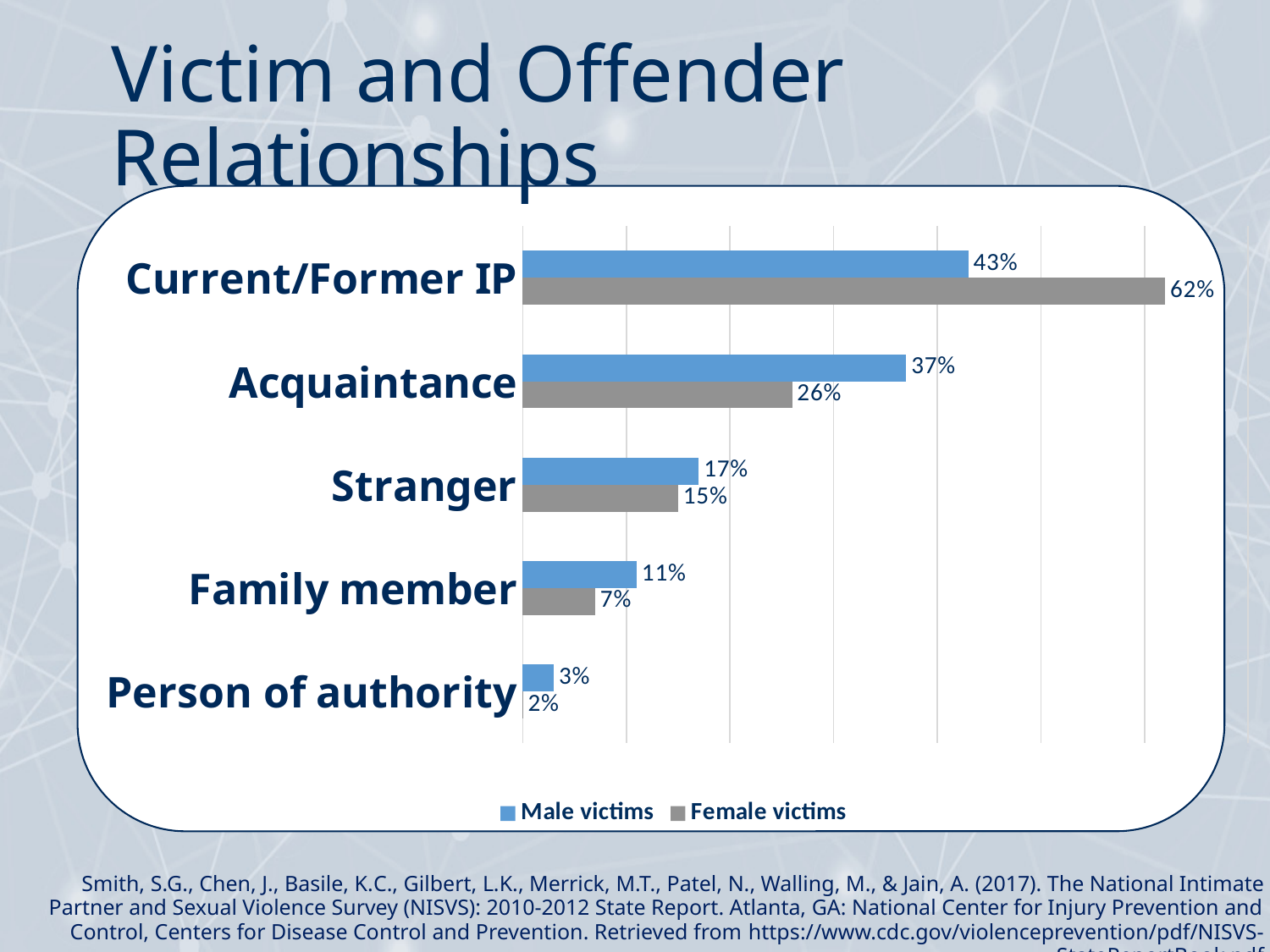
What is the difference between the Male victims and Female victims values for Acquaintance? 11% How many relationship categories are shown in the chart? 5 What is the difference between the Female victims and Male victims values for Current/Former IP? 19% Which category has the lowest value for Female victims? Person of authority What is the value for Female victims in the Current/Former IP category? 62% Which category has the highest value for Male victims? Current/Former IP What kind of chart is shown on the slide? Bar chart Which colour represents Female victims in the chart? Grey What is the value for Male victims in the Acquaintance category? 37% Which is larger for the Stranger category, the Male victims value or the Female victims value? Male victims What is the value for Female victims in the Family member category? 7% How many series does the legend list? 2